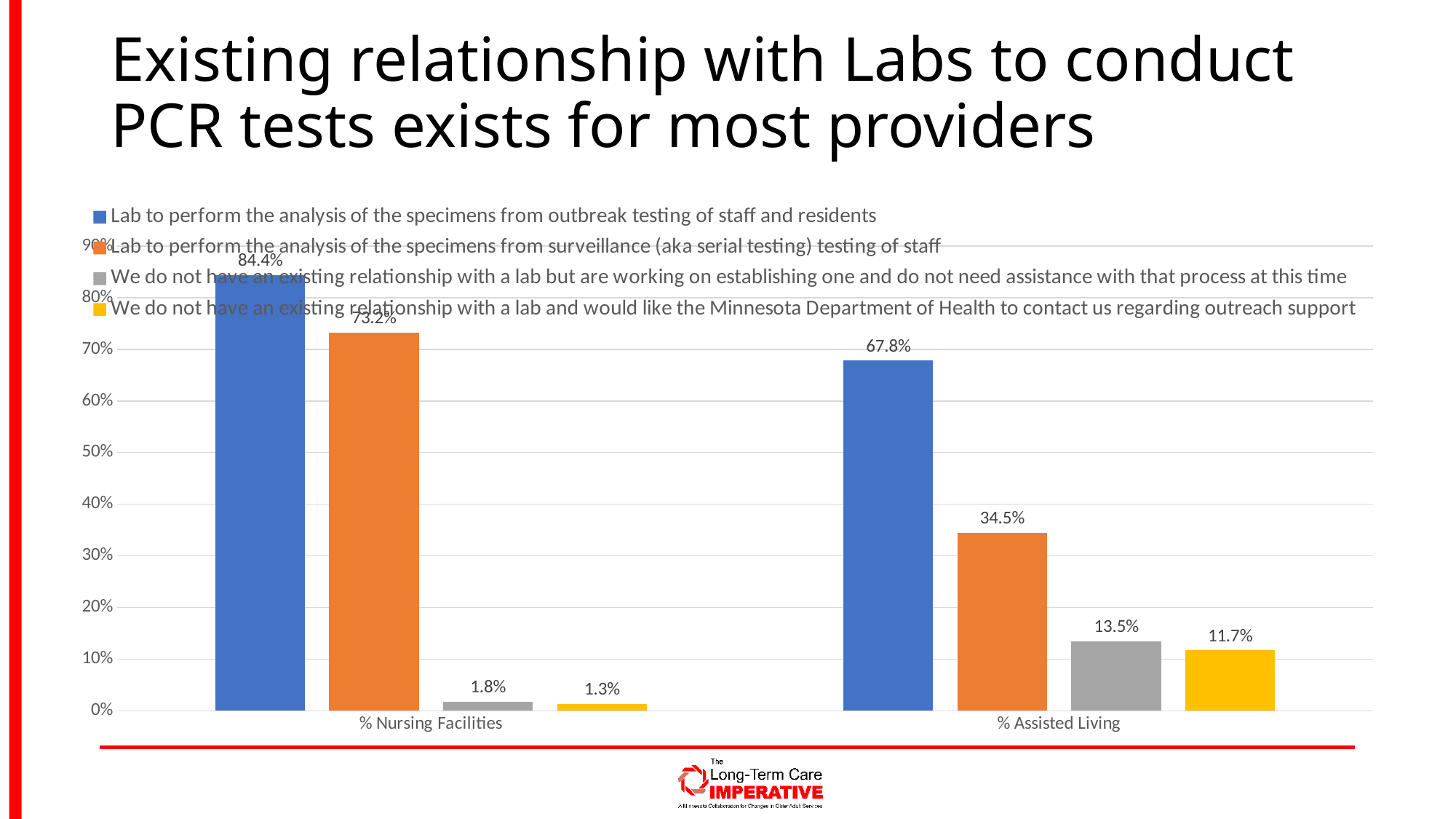
What is the value for 'Lab to perform the analysis of the specimens from surveillance (aka serial testing) testing of staff' for % Assisted Living? 34.5% What is the value for 'Lab to perform the analysis of the specimens from outbreak testing of staff and residents' for % Nursing Facilities? 84.4% How many series does the legend list? 4 What colour are the bars for 'We do not have an existing relationship with a lab but are working on establishing one and do not need assistance with that process at this time'? gray What is the value for 'We do not have an existing relationship with a lab but are working on establishing one and do not need assistance with that process at this time' for % Assisted Living? 13.5% Is the value for 'Lab to perform the analysis of the specimens from surveillance (aka serial testing) testing of staff' for % Nursing Facilities greater or less than 70%? greater What kind of chart is shown on the slide? bar chart Which series has the lowest value for % Assisted Living? We do not have an existing relationship with a lab and would like the Minnesota Department of Health to contact us regarding outreach support What is the difference between the 'Lab to perform the analysis of the specimens from outbreak testing of staff and residents' values for % Nursing Facilities and % Assisted Living? 16.6% How many categories are shown on the x axis? 2 Which category has the higher value for 'Lab to perform the analysis of the specimens from outbreak testing of staff and residents'? % Nursing Facilities What is the value for 'We do not have an existing relationship with a lab and would like the Minnesota Department of Health to contact us regarding outreach support' for % Nursing Facilities? 1.3%